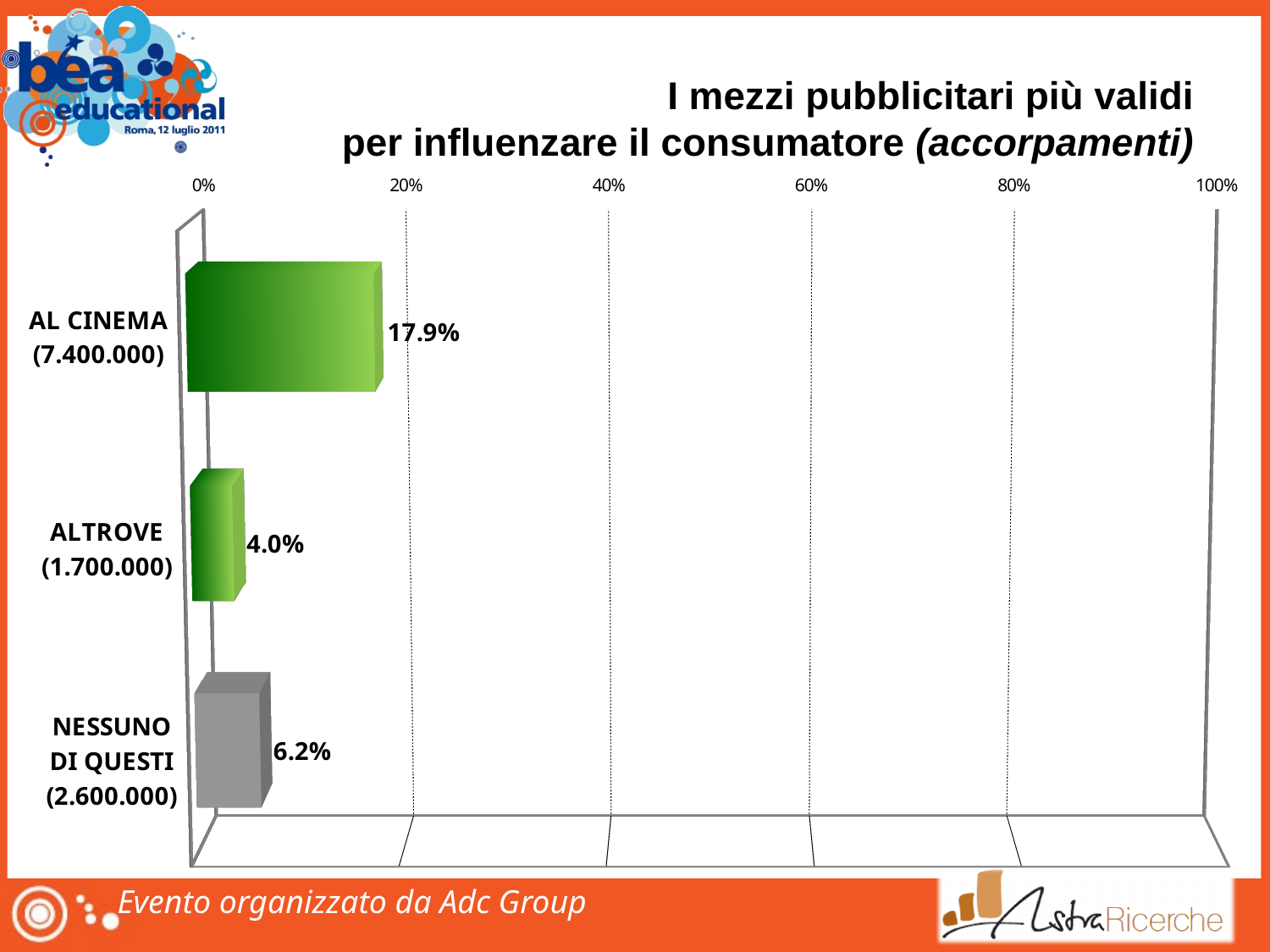
What is the difference between the values for AL CINEMA and ALTROVE? 13.9% What is the value for ALTROVE? 4.0% What is the value for NESSUNO DI QUESTI? 6.2% What is the value for AL CINEMA? 17.9% How many categories are shown in the chart? 3 Which is larger, the value for NESSUNO DI QUESTI or the value for ALTROVE? NESSUNO DI QUESTI Which category has the highest value? AL CINEMA What is the difference between the values for NESSUNO DI QUESTI and ALTROVE? 2.2% Is the value for AL CINEMA greater or less than 20%? less What kind of chart is shown on the slide? bar chart What number is shown in parentheses under the AL CINEMA label? 7.400.000 Which category has the lowest value? ALTROVE